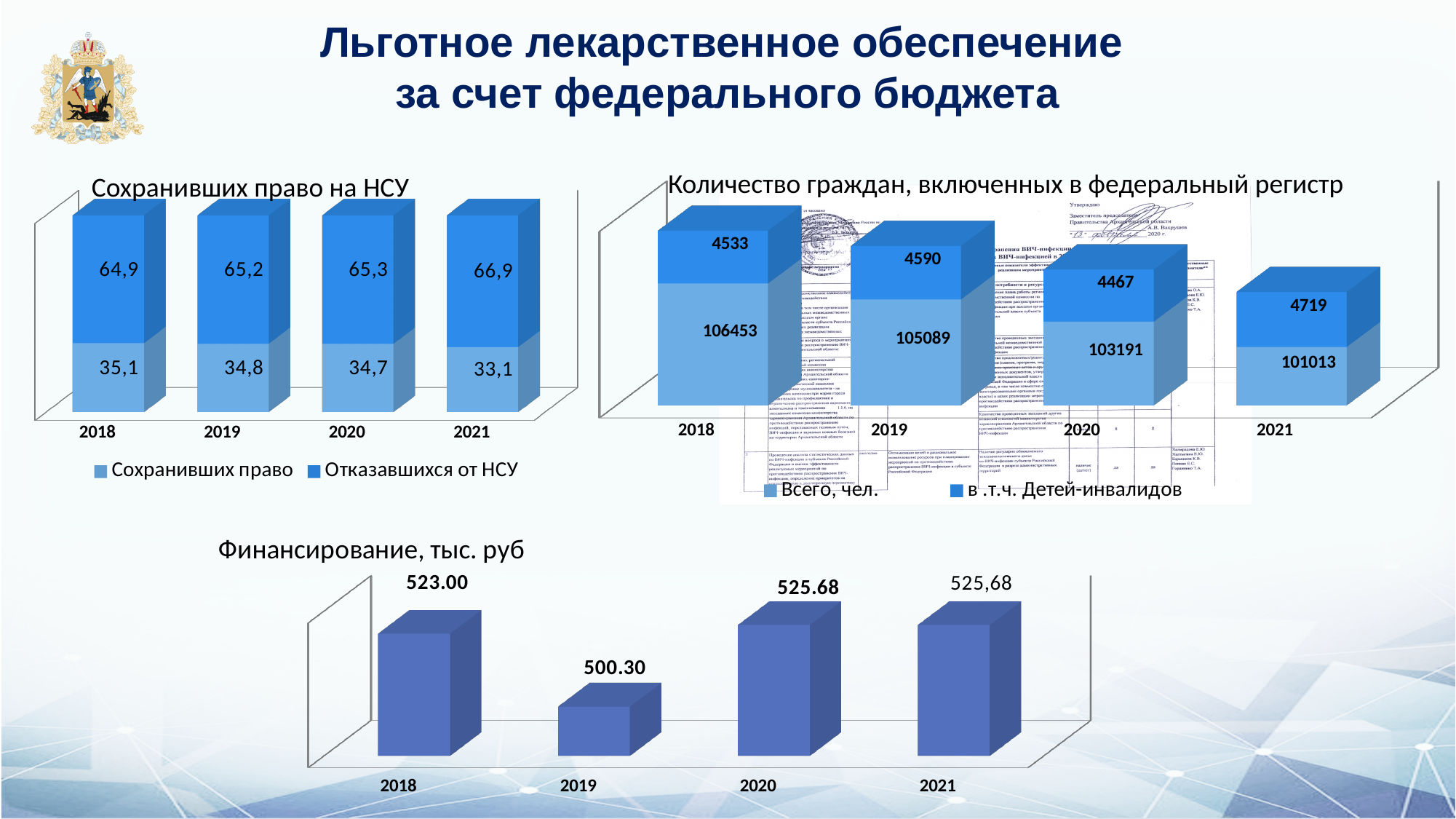
In the chart 'Количество граждан, включенных в федеральный регистр', what is the difference between the 'Всего, чел.' values for 2018 and 2021? 5440 In the chart 'Финансирование, тыс. руб', which year has the lowest value? 2019 In the chart 'Сохранивших право на НСУ', does the 'Сохранивших право' series rise or fall from 2018 to 2021? fall In the chart 'Сохранивших право на НСУ', which year has the lowest value for 'Сохранивших право'? 2021 In the chart 'Сохранивших право на НСУ', what is the value for 'Отказавшихся от НСУ' in 2021? 66,9 In the chart 'Количество граждан, включенных в федеральный регистр', what is the value for 'в .т.ч. Детей-инвалидов' in 2020? 4467 In the chart 'Финансирование, тыс. руб', what is the value for 2019? 500.30 In the chart 'Количество граждан, включенных в федеральный регистр', which year has the highest value for 'в .т.ч. Детей-инвалидов'? 2021 In the chart 'Сохранивших право на НСУ', what is the value for 'Сохранивших право' in 2018? 35,1 What kind of chart is 'Финансирование, тыс. руб'? bar chart In the chart 'Количество граждан, включенных в федеральный регистр', how many series does the legend list? 2 In the chart 'Количество граждан, включенных в федеральный регистр', what is the value for 'Всего, чел.' in 2019? 105089